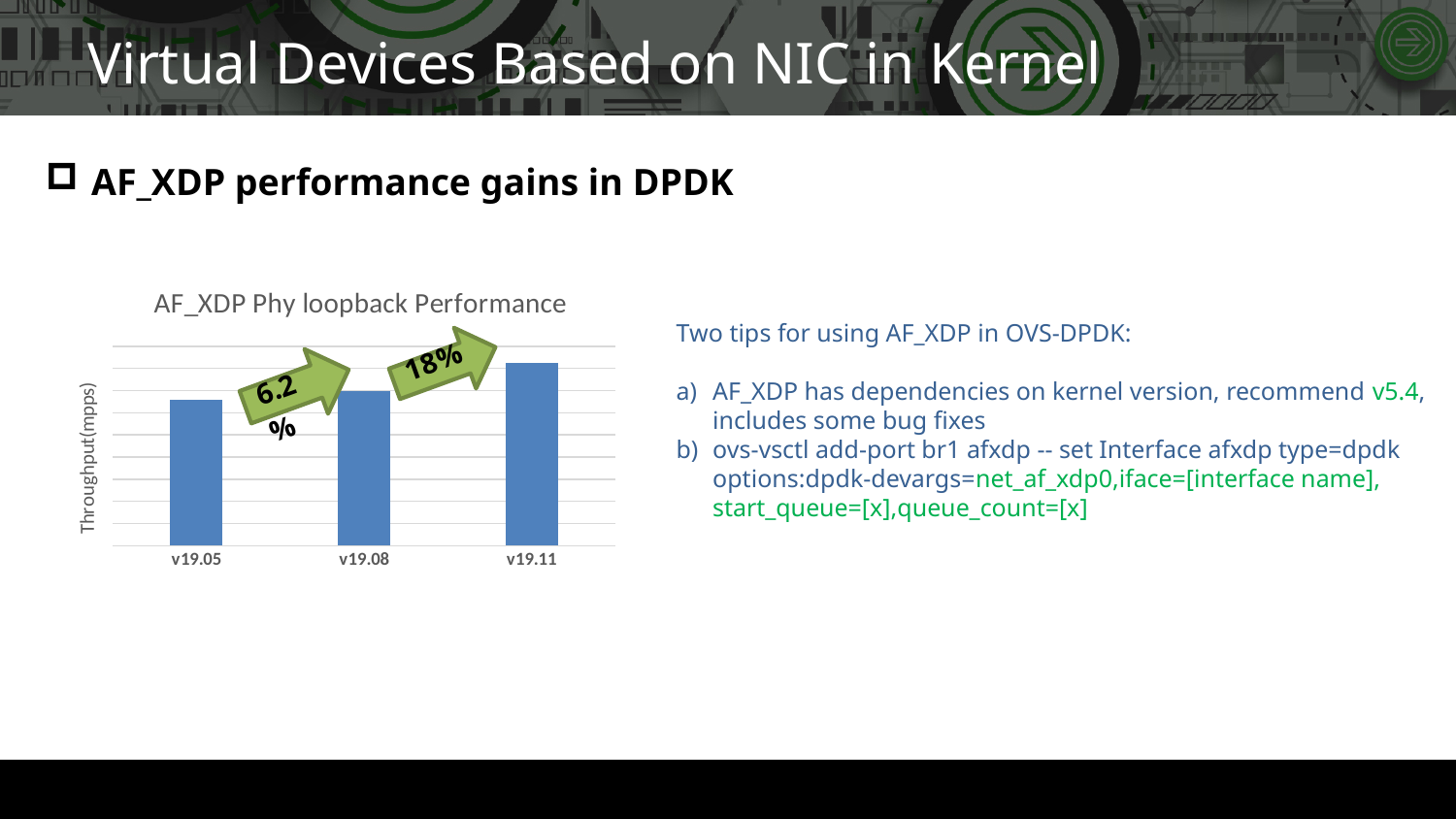
Which has higher throughput, v19.05 or v19.11? v19.11 Does throughput rise or fall from v19.05 to v19.11 in the chart? rise Which has higher throughput, v19.08 or v19.11? v19.11 What type of chart is shown on the slide? bar chart What percentage gain is annotated on the arrow between v19.08 and v19.11? 18% What is the title of the chart on the slide? AF_XDP Phy loopback Performance How many DPDK versions are plotted in the AF_XDP Phy loopback Performance chart? 3 Which version has the highest throughput in the AF_XDP Phy loopback Performance chart? v19.11